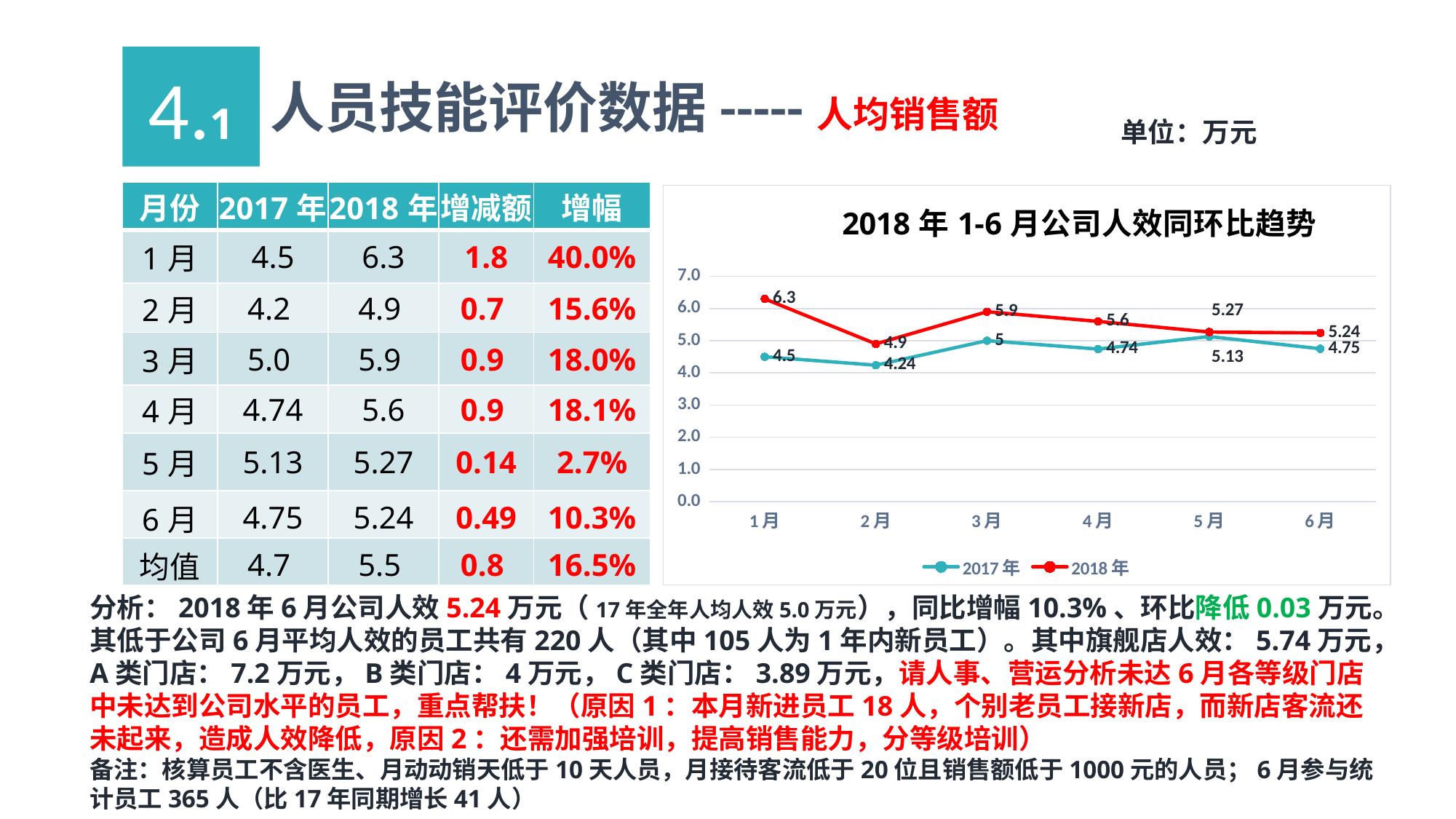
Which series has the larger value in 3月, 2017年 or 2018年? 2018年 How many series does the chart legend list? 2 What type of chart is shown on the slide? line chart What is the value for 2018年 in 1月 on the chart? 6.3 What is the difference between the 2018年 and 2017年 values in 1月? 1.8 In which month is the 2017年 series lowest? 2月 In which month is the 2018年 series highest? 1月 Does the 2018年 series rise or fall from 1月 to 2月? fall What is the value for 2017年 in 2月 on the chart? 4.24 What is the title of the chart? 2018年1-6月公司人效同环比趋势 What is the value for 2018年 in 5月 on the chart? 5.27 How many months are plotted on the x axis of the chart? 6